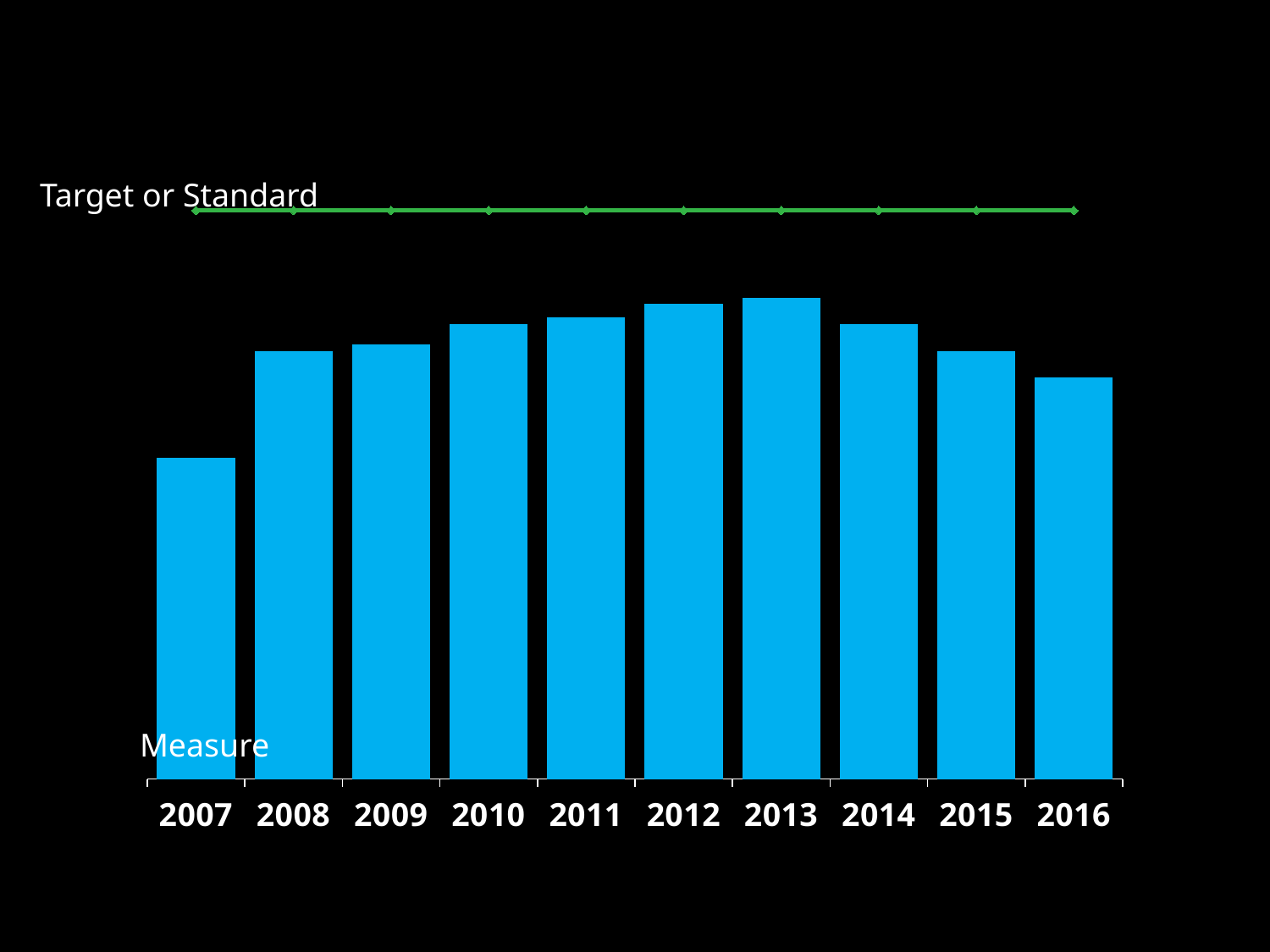
Does any bar in the chart reach the green 'Target or Standard' line? No Which year has the larger value, 2010 or 2016? 2010 Which year has the lowest bar in the chart? 2007 Which year has the larger value, 2013 or 2016? 2013 What kind of chart is shown on the slide? Combination bar and line chart Which year has the highest bar in the chart? 2013 How many years are shown on the x axis of the chart? 10 Do the bar values rise or fall from 2013 to 2016? Fall What is the label of the green horizontal line in the chart? Target or Standard What is the label given to the blue bars in the chart? Measure Do the bar values rise or fall from 2007 to 2013? Rise